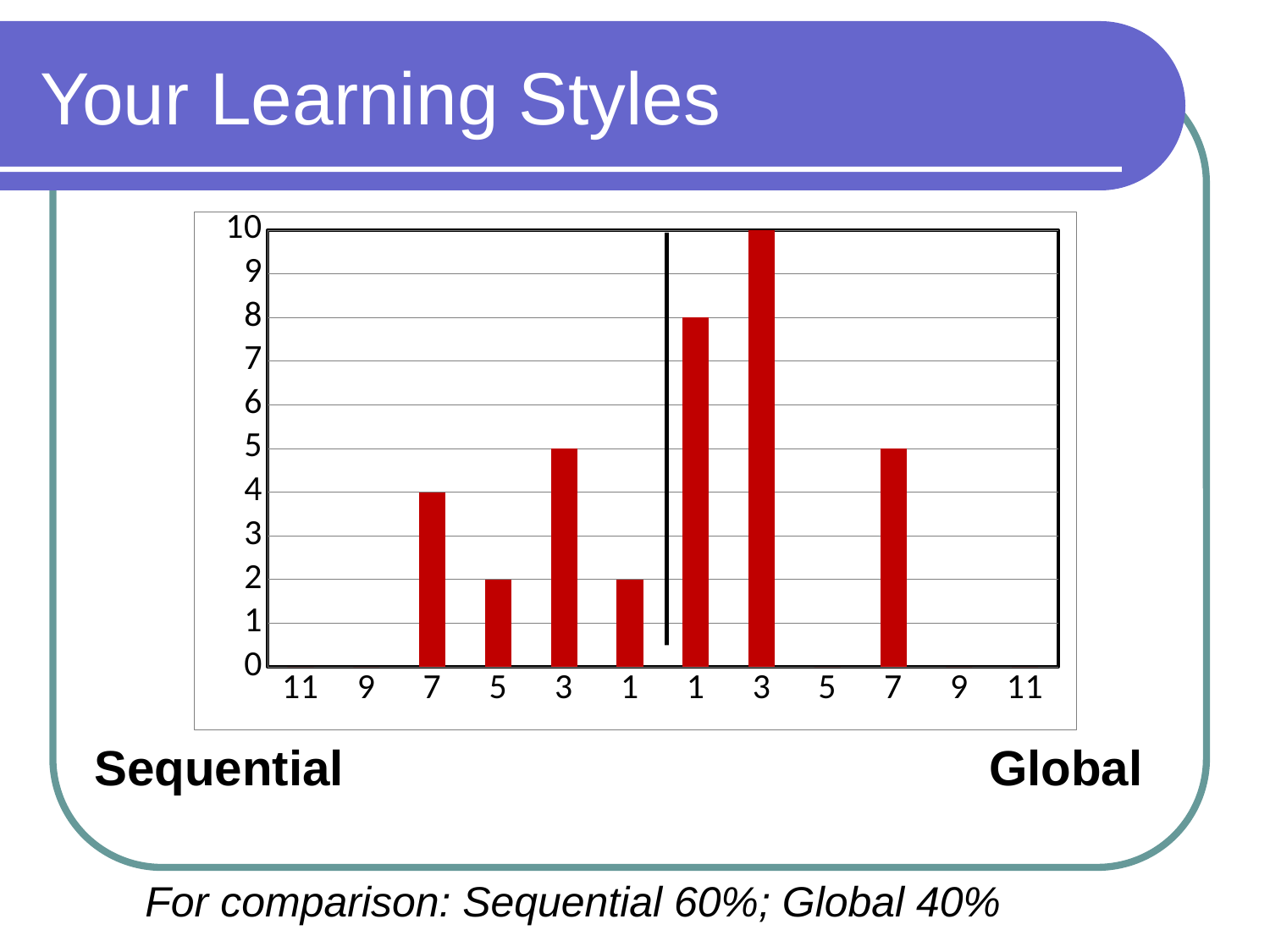
Which x-axis position has the tallest bar? 3 on the Global side How many category labels are shown on the x axis? 12 What is the value of the bar at 1 on the Global side of the chart? 8 What is the value of the bar at 7 on the Sequential side of the chart? 4 What is the value of the bar at 3 on the Sequential side of the chart? 5 What is the value of the bar at 3 on the Global side of the chart? 10 What is the difference between the bar at 3 on the Global side and the bar at 3 on the Sequential side? 5 What are the two labels printed below the chart at its left and right ends? Sequential and Global Which is larger: the bar at 7 on the Sequential side or the bar at 7 on the Global side? 7 on the Global side How many bars are plotted on the chart? 7 What kind of chart is shown on the slide? bar chart What is the highest value shown on the y axis? 10